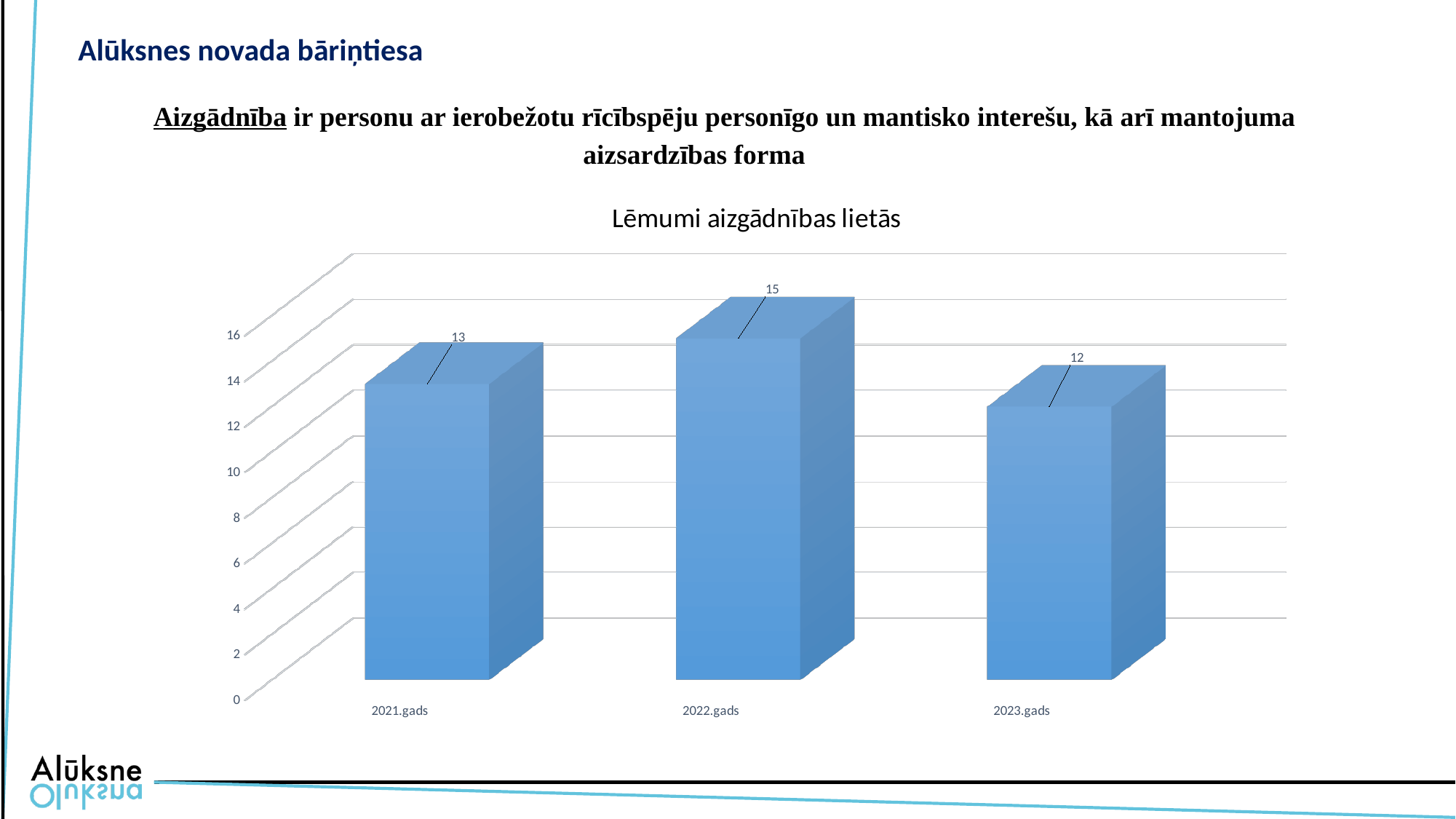
What is the value for 2022.gads? 15 What is the difference between the values for 2022.gads and 2023.gads? 3 What kind of chart is shown on the slide? bar chart What is the value for 2023.gads? 12 How many years are shown on the chart? 3 What is the value for 2021.gads? 13 What is the difference between the values for 2021.gads and 2023.gads? 1 Which year has the highest value? 2022.gads Which year has the lowest value? 2023.gads What is the title of the chart? Lēmumi aizgādnības lietās Which is larger, the value for 2021.gads or the value for 2022.gads? 2022.gads Is the value for 2022.gads greater or less than 14? greater